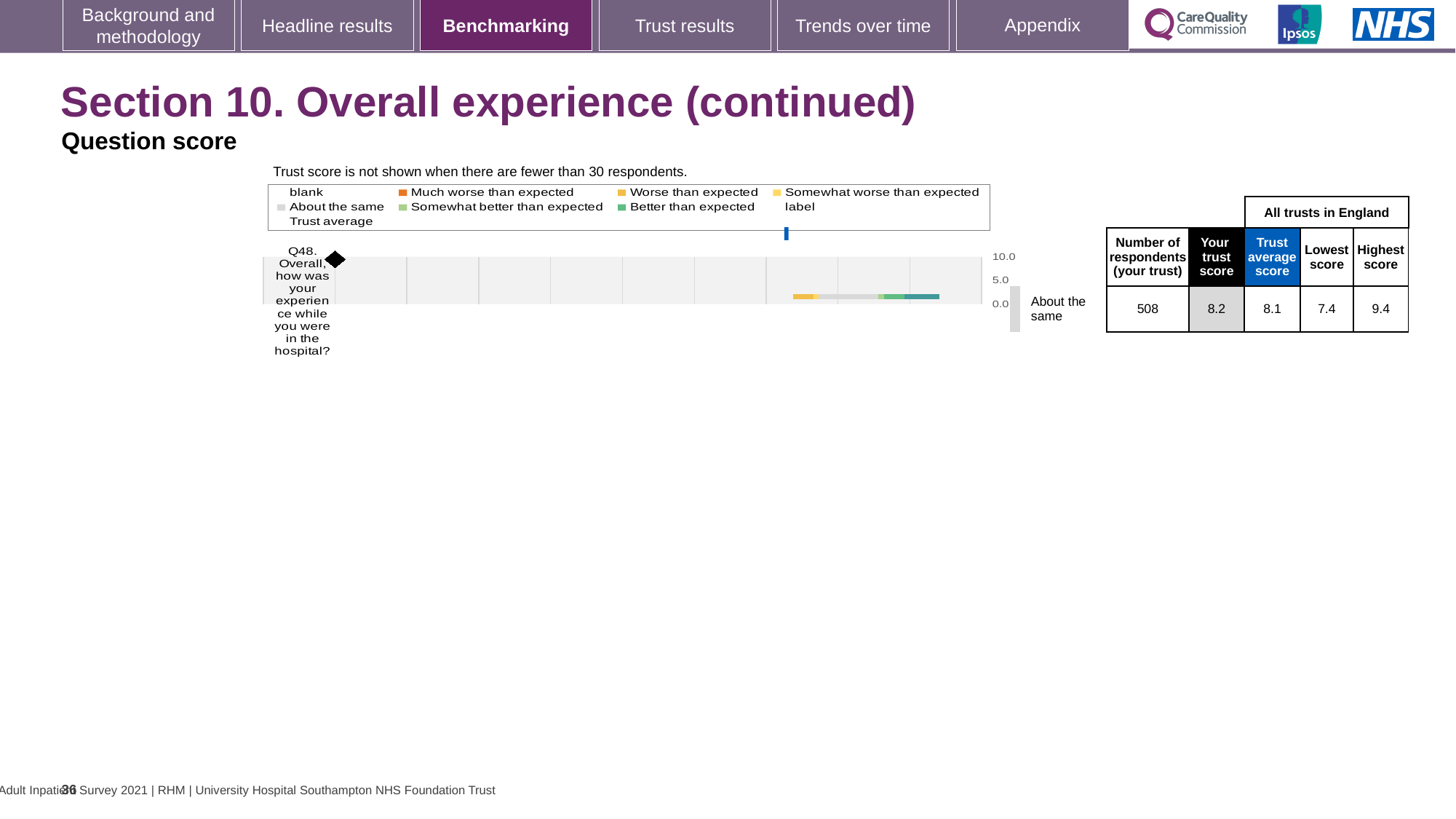
What kind of chart is used to show the Q48 question score? bar chart How many questions are plotted in the question score chart? 1 What is the difference between the highest score and the lowest score for Q48? 2.0 Which question is plotted in the question score chart? Q48. Overall, how was your experience while you were in the hospital? Is your trust score for Q48 greater or less than 5.0? greater Which benchmark category is the trust's Q48 score assigned to? About the same What is the 'Trust average score' for Q48? 8.1 What is the lowest score among all trusts in England for Q48? 7.4 What is the highest score among all trusts in England for Q48? 9.4 What is the 'Your trust score' value for Q48? 8.2 How many respondents from your trust answered Q48? 508 Which is larger for Q48, your trust score or the trust average score? Your trust score